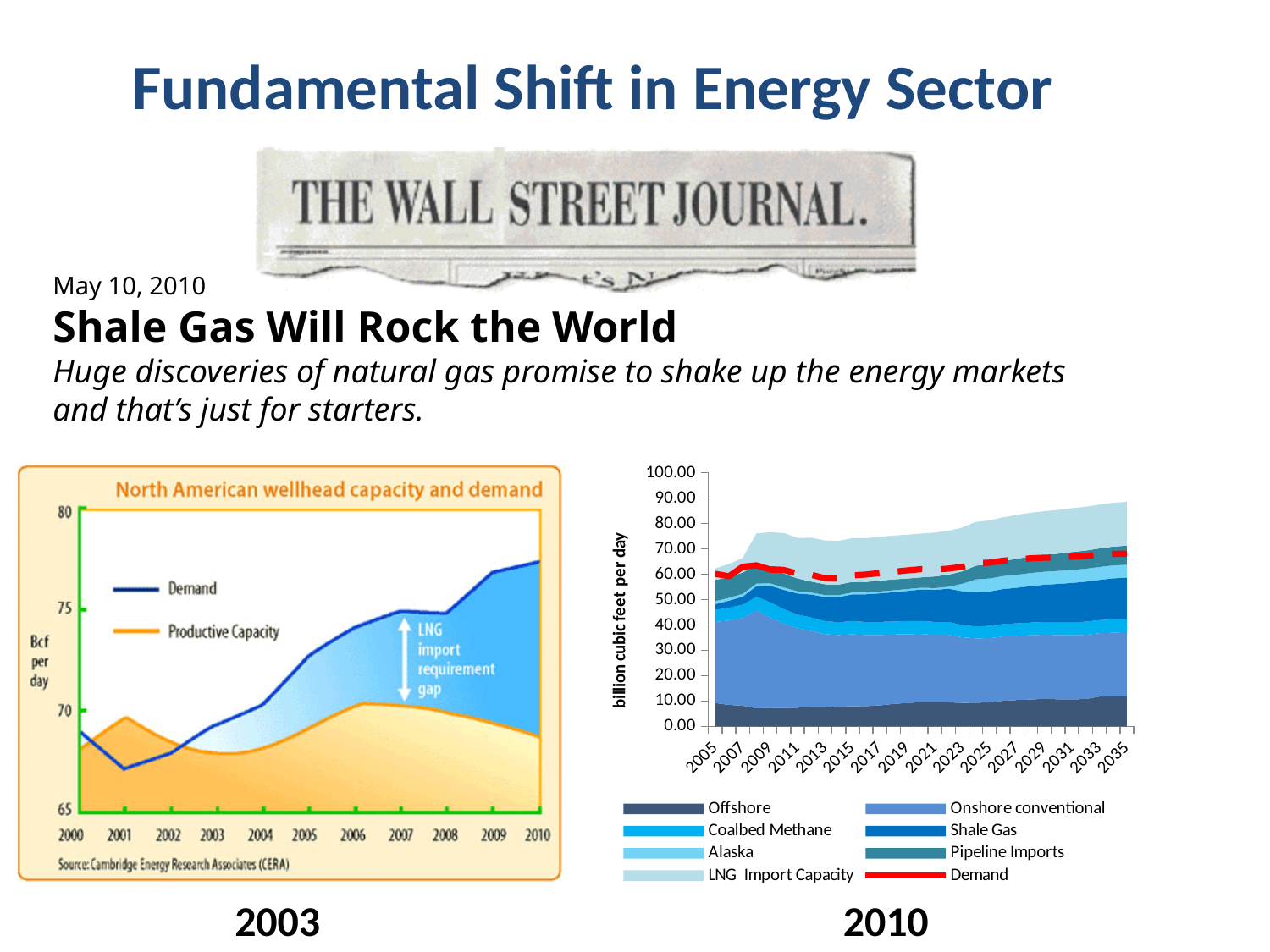
In the left chart 'North American wellhead capacity and demand', is the Demand value in 2010 greater or less than 75? greater In the right chart (labelled 2010), is the total of the stacked areas in 2035 greater or less than 80.00? greater In the right chart (labelled 2010), is the Demand value in 2035 greater or less than 70.00? less How many years are labelled on the x axis of the left chart 'North American wellhead capacity and demand'? 11 What is the y-axis label of the right chart (labelled 2010)? billion cubic feet per day What kind of chart is the right chart (labelled 2010)? stacked area chart What kind of chart is the left chart titled 'North American wellhead capacity and demand'? line chart How many series does the legend of the left chart 'North American wellhead capacity and demand' list? 2 In the left chart 'North American wellhead capacity and demand', does Demand rise or fall from 2003 to 2010? rise In the left chart 'North American wellhead capacity and demand', which is larger in 2010, Demand or Productive Capacity? Demand How many entries does the legend of the right chart (labelled 2010) list? 8